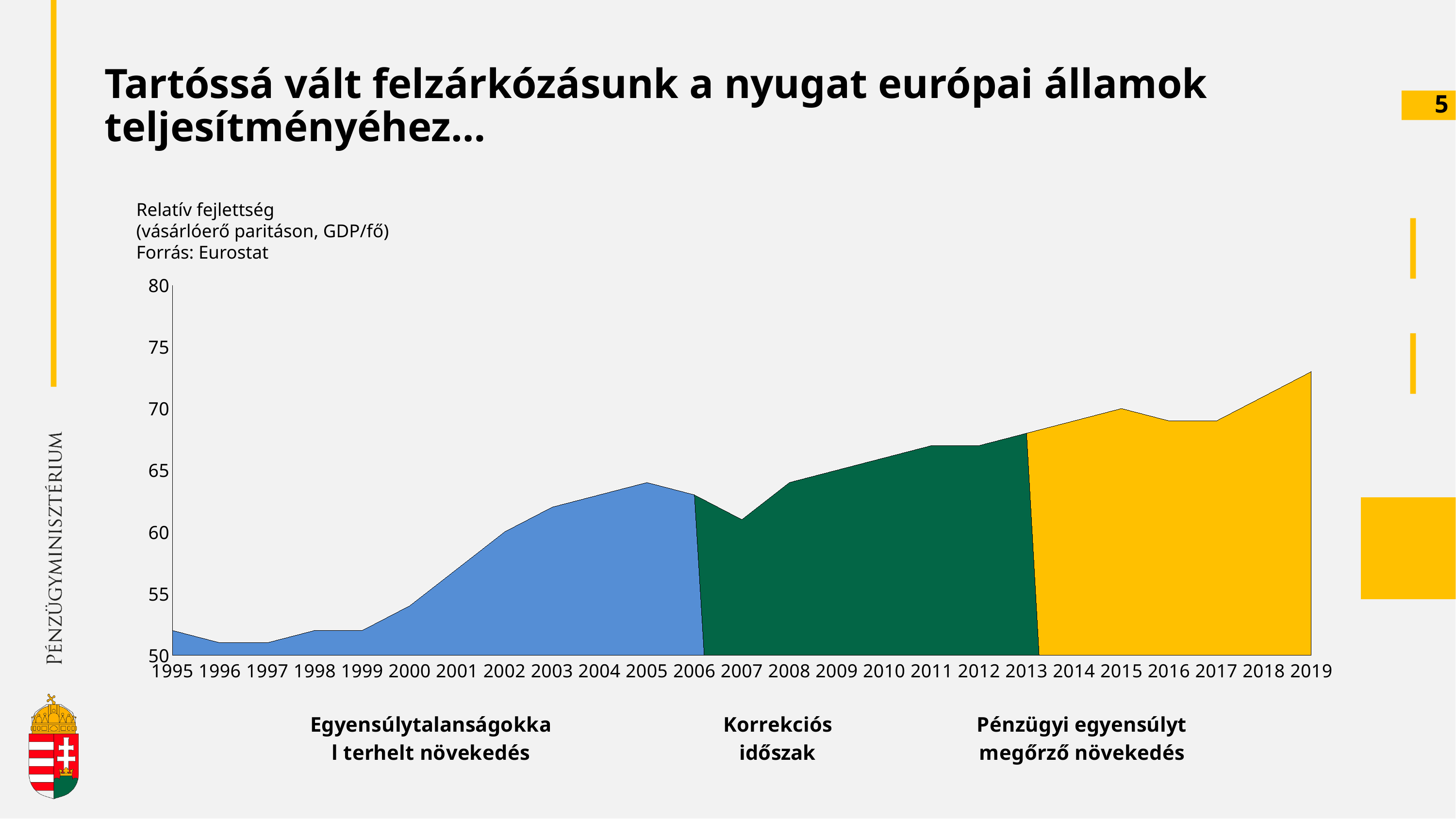
Does the value generally rise or fall from 1995 to 2019? rise Which is larger, the value for 2005 or the value for 2007? 2005 How many years are shown on the x axis of the chart? 25 Is the value for 2002 greater or less than 55? greater What kind of chart is shown on the slide? area chart What source is cited for the chart data? Eurostat Which year has the highest value in the chart? 2019 Is the value for 2019 greater or less than 70? greater Is the value for 2013 greater or less than 65? greater What label is given to the period shown in yellow (2013–2019)? Pénzügyi egyensúlyt megőrző növekedés